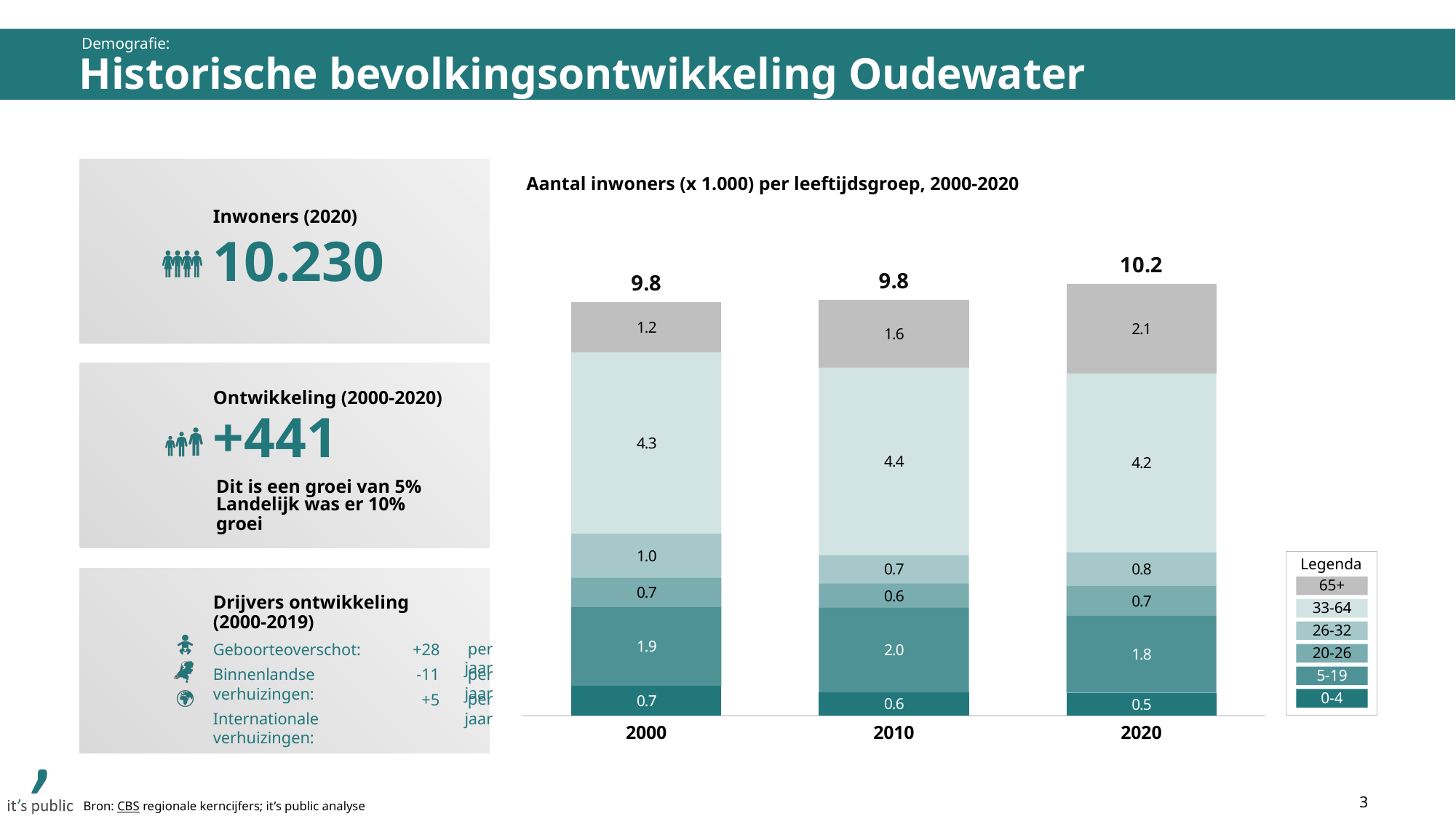
What is the value for the 33-64 age group in 2010? 4.4 What is the value for the 65+ age group in 2020? 2.1 Which year has the highest total number of inhabitants? 2020 How many years are shown on the x axis? 3 What is the value for the 0-4 age group in 2000? 0.7 What is the total shown above the stacked bar for 2020? 10.2 What is the difference between the 65+ value in 2020 and the 65+ value in 2000? 0.9 Is the 5-19 value larger in 2010 or in 2020? 2010 Which age group has the largest value in the 2000 bar? 33-64 How many age groups does the legend list? 6 What kind of chart is shown on the slide? Stacked bar chart Which age group has the smallest value in the 2020 bar? 0-4